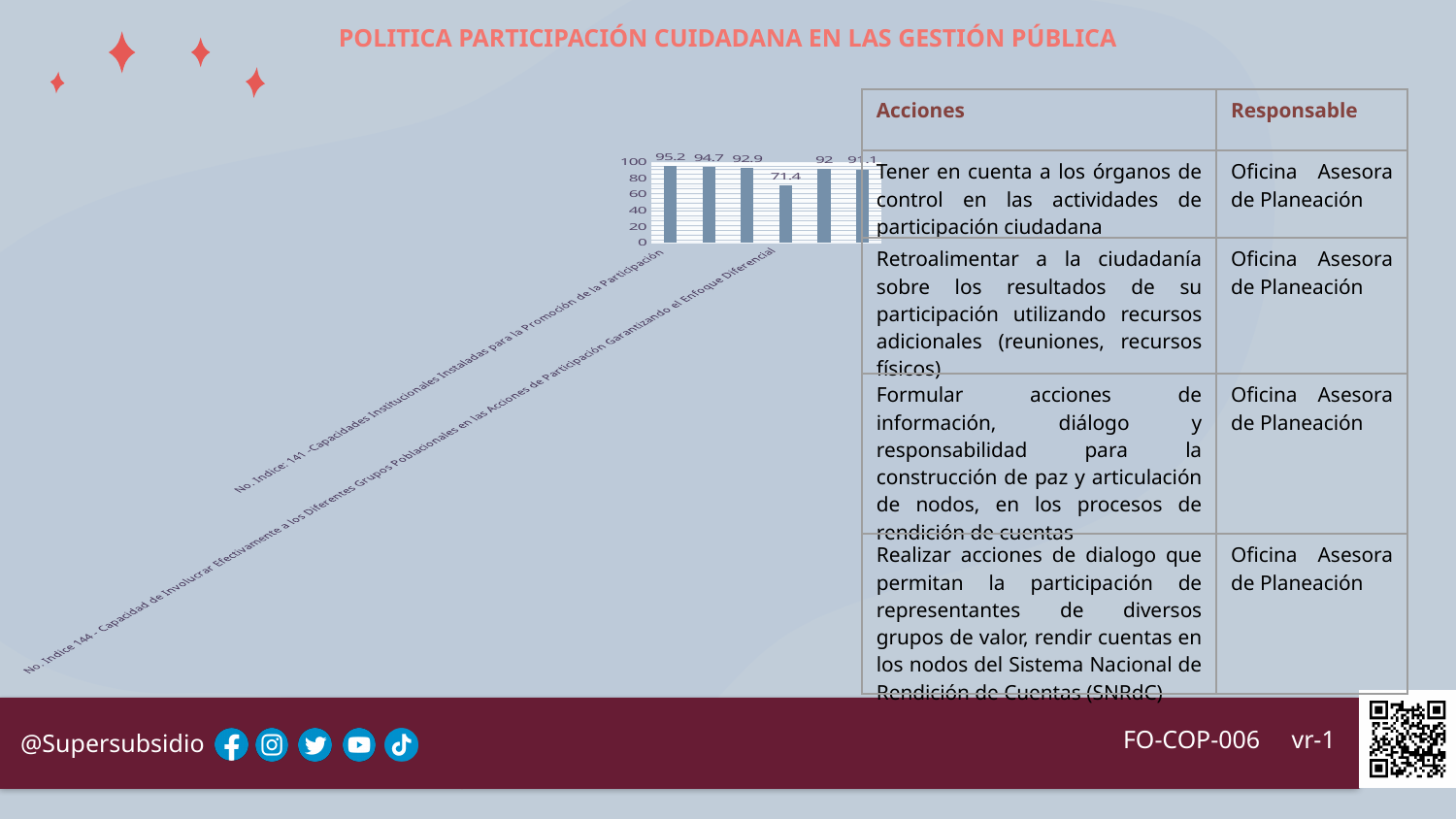
Which is larger, the second bar from the left or the third bar from the left? the second bar (94.7) What is the lowest value shown in the chart? 71.4 How many bars does the chart contain? 6 What kind of chart is shown on the slide? bar chart What is the value of the leftmost bar in the chart? 95.2 What is the highest value shown in the chart? 95.2 What is the value of the rightmost bar in the chart? 91.1 Is the lowest bar in the chart greater or less than 80? less What is the difference between the leftmost bar (95.2) and the rightmost bar (91.1)? 4.1 What is the difference between the highest and lowest values in the chart? 23.8 What is the maximum value shown on the chart's vertical axis? 100 How many bars in the chart have a value above 90? 5